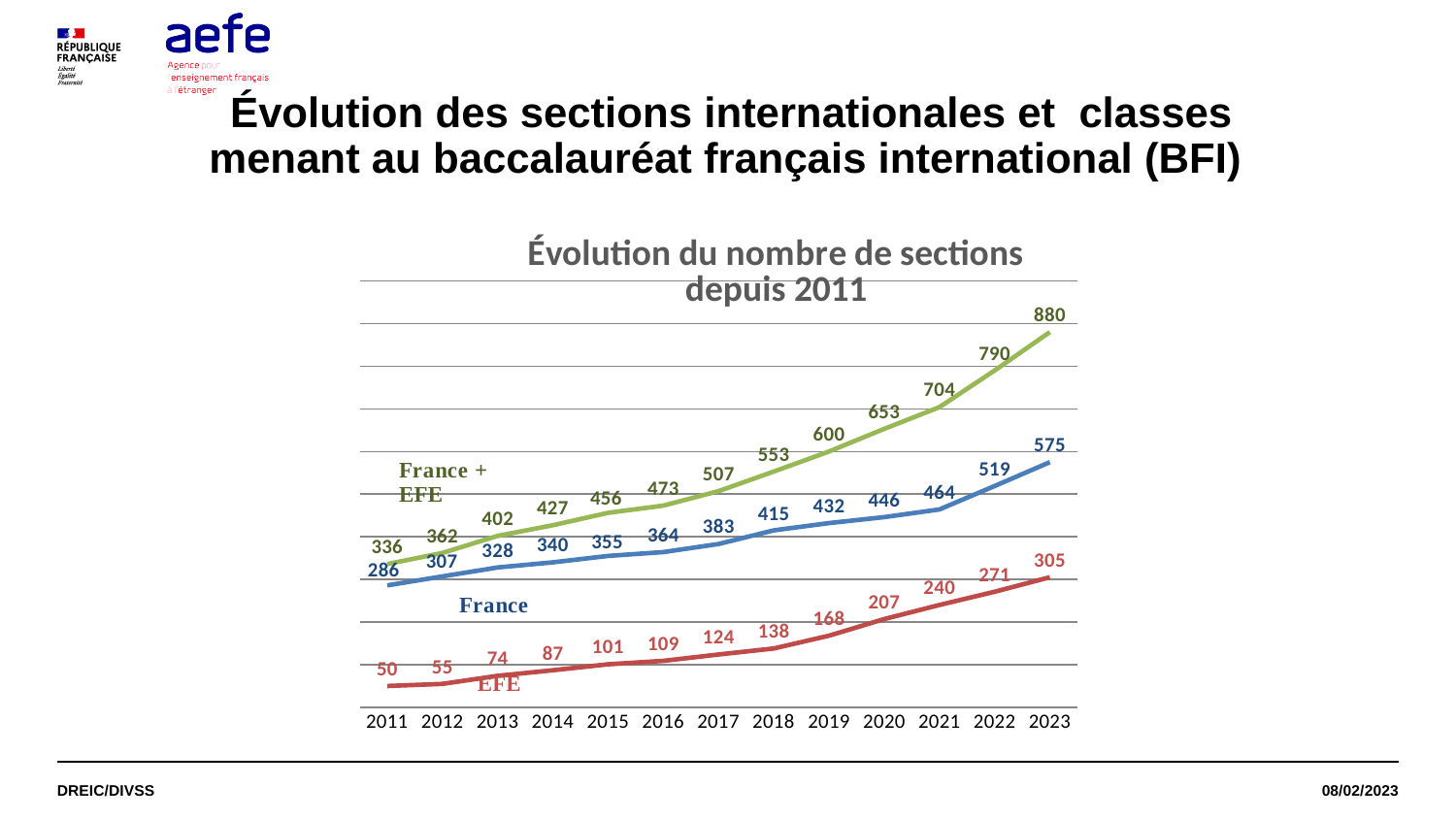
What is the difference between the France + EFE value in 2023 and its value in 2022? 90 In which year is the France + EFE series at its highest? 2023 Which is larger in 2019: the France value or the EFE value? France What kind of chart is this? Line chart In which year is the EFE series at its lowest? 2011 What is the value of the France + EFE series in 2023? 880 Does the EFE series rise or fall from 2011 to 2023? Rise What is the value of the EFE series in 2020? 207 How many years are shown on the x axis? 13 What is the value of the France series in 2018? 415 What is the difference between the France value and the EFE value in 2023? 270 What is the value of the France series in 2011? 286